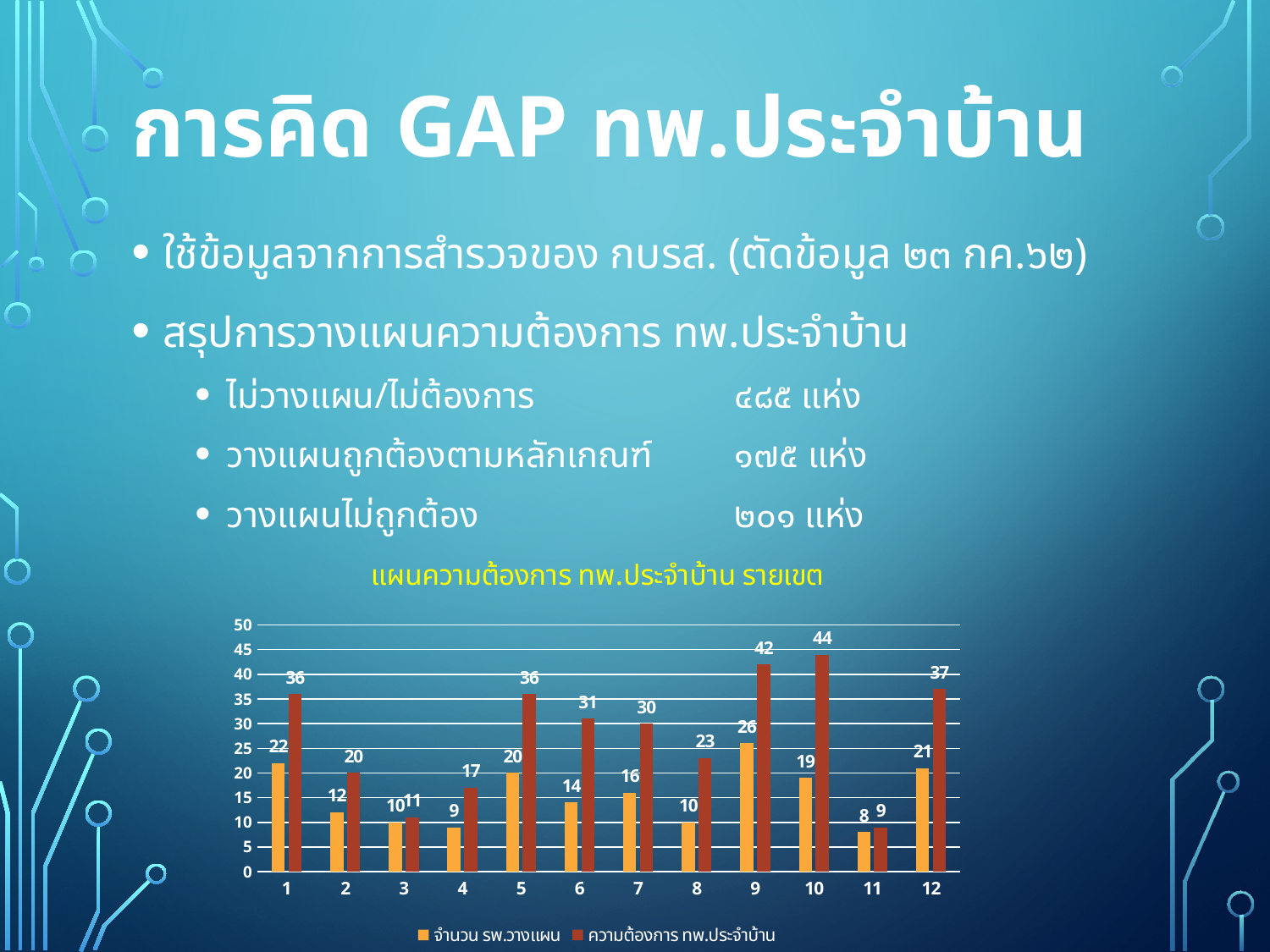
How many series does the chart legend list? 2 Which เขต has the lowest value for จำนวน รพ.วางแผน? 11 What type of chart is shown on the slide? bar chart What is the value of จำนวน รพ.วางแผน for เขต 9? 26 What is the difference between ความต้องการ ทพ.ประจำบ้าน and จำนวน รพ.วางแผน for เขต 1? 14 What is the difference between ความต้องการ ทพ.ประจำบ้าน for เขต 9 and เขต 8? 19 Which เขต has the highest value for ความต้องการ ทพ.ประจำบ้าน? 10 What is the value of ความต้องการ ทพ.ประจำบ้าน for เขต 10? 44 What is the value of จำนวน รพ.วางแผน for เขต 12? 21 Which is larger for เขต 5: จำนวน รพ.วางแผน or ความต้องการ ทพ.ประจำบ้าน? ความต้องการ ทพ.ประจำบ้าน What is the title of the chart? แผนความต้องการ ทพ.ประจำบ้าน รายเขต How many categories (เขต) are shown on the x axis of the chart? 12